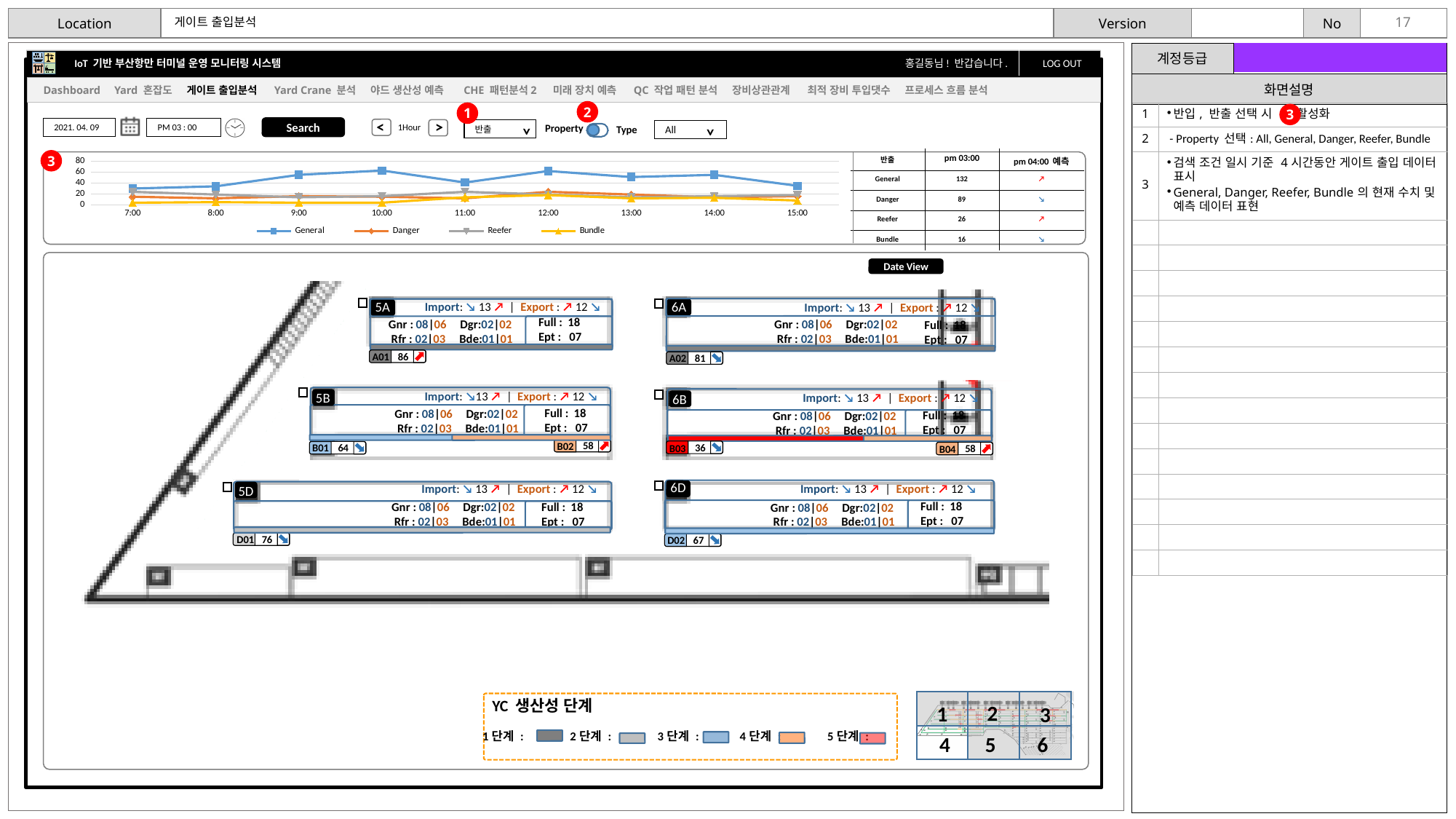
Is the value for Bundle at 7:00 greater or less than 20? less Does the General line rise or fall from 14:00 to 15:00? fall At 12:00, which is larger in the line chart, General or Bundle? General What kind of chart is shown at the top of the dashboard? line chart Is the value for General at 10:00 greater or less than 40? greater Is the value for General at 12:00 greater or less than 40? greater Does the General line rise or fall from 7:00 to 10:00? rise Which series has the highest value at 12:00 in the line chart? General How many series does the legend of the line chart list? 4 What colour is the General line in the chart? blue How many time points are shown along the x axis of the line chart? 9 What are the four legend entries of the line chart? General, Danger, Reefer, Bundle